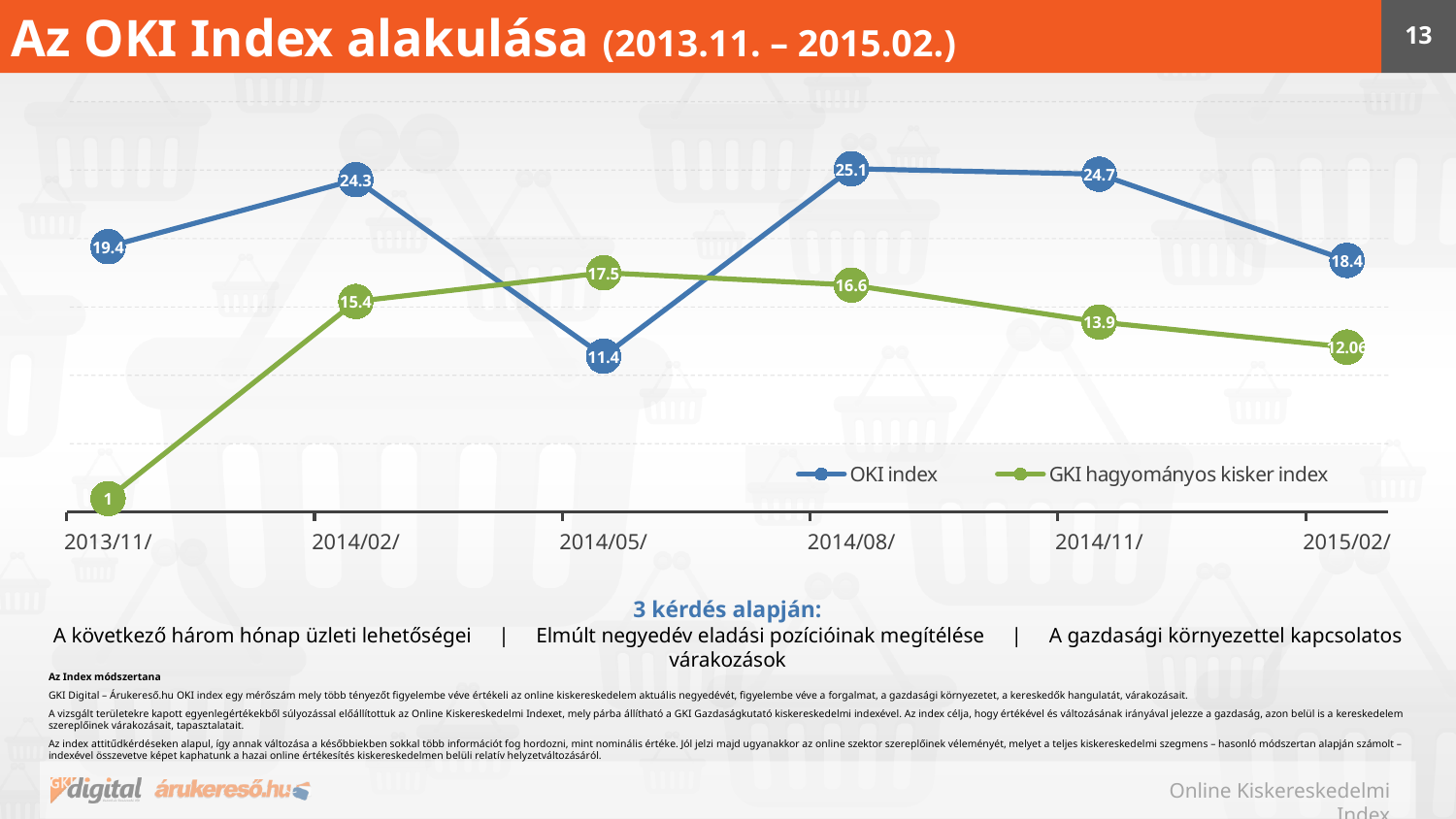
How many series does the legend list? 2 At which time point is the GKI hagyományos kisker index lowest? 2013/11/ What is the title of the chart on the slide? Az OKI Index alakulása (2013.11. – 2015.02.) How many time points are plotted along the x axis? 6 What is the value of the GKI hagyományos kisker index at 2015/02/? 12.06 At which time point is the OKI index highest? 2014/08/ Does the GKI hagyományos kisker index rise or fall from 2014/05/ to 2015/02/? fall What is the value of the OKI index at 2014/05/? 11.4 What kind of chart is shown on the slide? line chart What is the value of the OKI index at 2014/08/? 25.1 What is the difference between the OKI index and the GKI hagyományos kisker index at 2014/02/? 8.9 Which series has the higher value at 2014/05/, OKI index or GKI hagyományos kisker index? GKI hagyományos kisker index